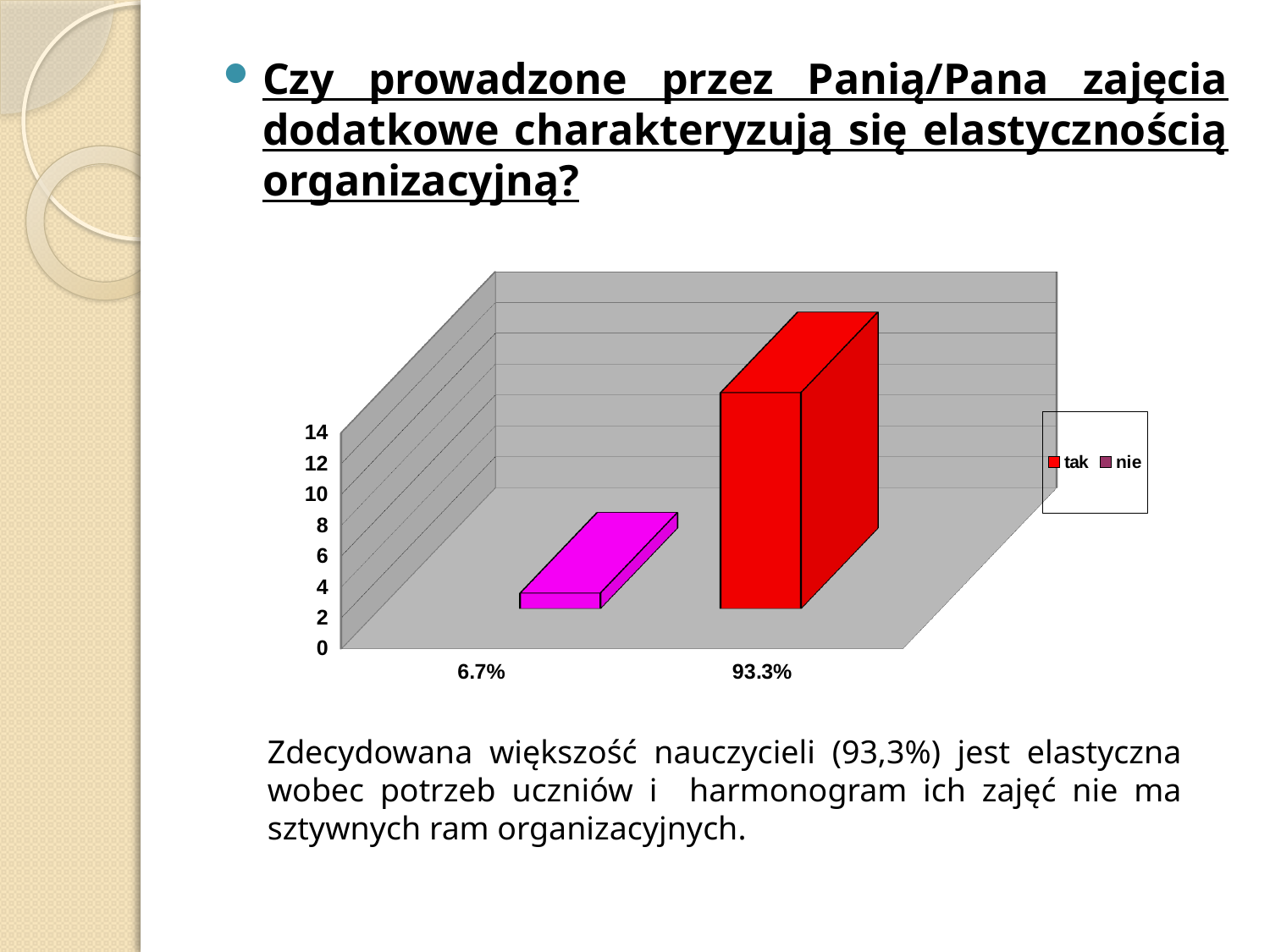
Which series is represented by the red bar according to the legend? tak Which series is represented by the magenta bar according to the legend? nie Is the value for tak greater or less than 10? greater What percentage label appears on the x axis under the magenta (nie) bar? 6.7% What percentage label appears on the x axis under the red (tak) bar? 93.3% How many bars are plotted in the chart? 2 Is the value for nie greater or less than 4? less What kind of chart is shown on the slide? bar chart How many series does the chart legend list? 2 Which series has the taller bar, tak or nie? tak Is the bar for tak taller or shorter than the bar for nie? taller Which series has the shorter bar, tak or nie? nie